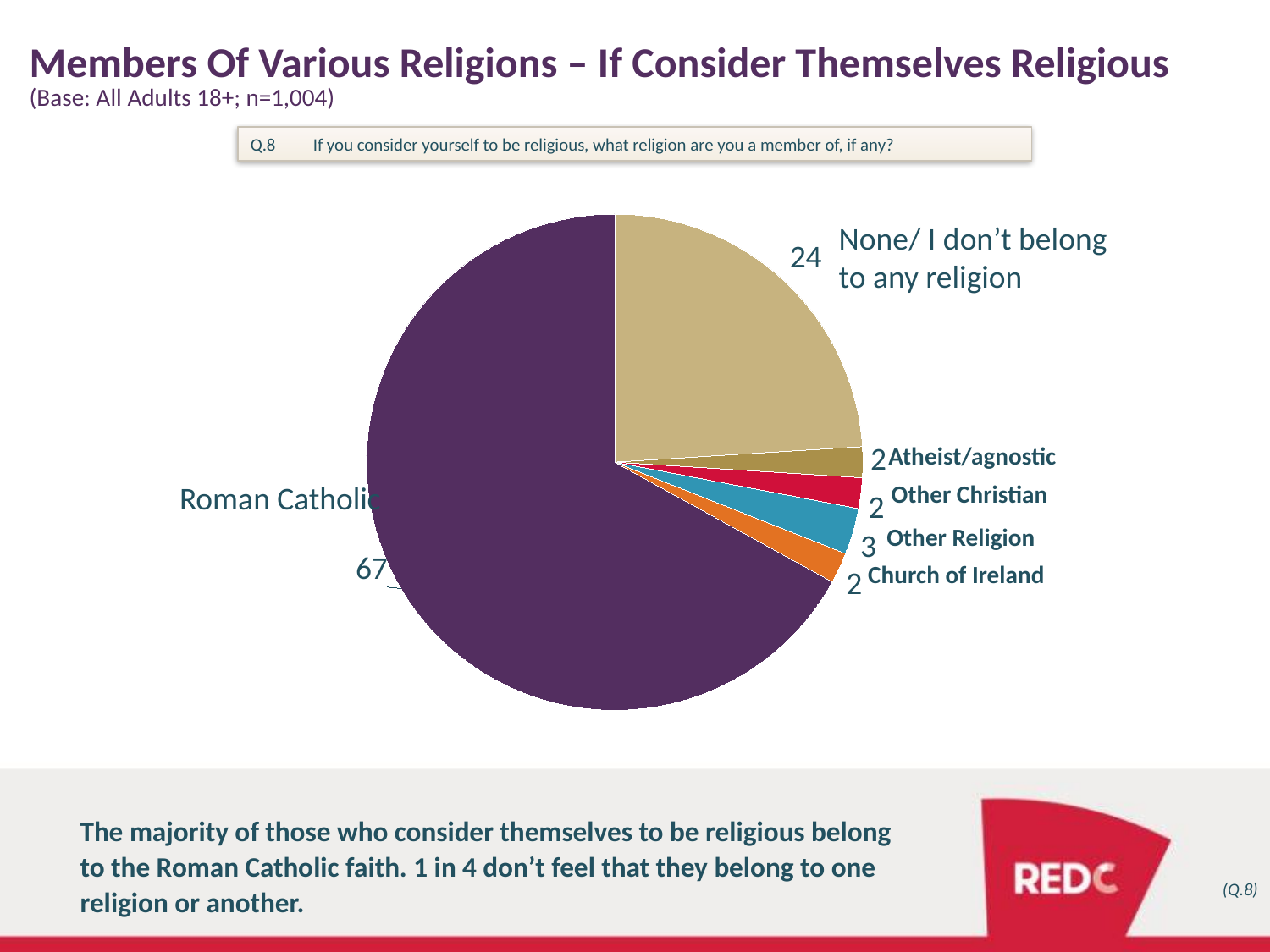
How many slices does the pie chart have? 6 Which is larger, the value for Other Religion or the value for Church of Ireland? Other Religion Which category has the largest slice of the pie? Roman Catholic What value is shown for Atheist/agnostic? 2 What value is shown for Other Religion? 3 What value is shown for Roman Catholic? 67 What value is shown for Church of Ireland? 2 What colour is the Roman Catholic slice? Purple What value is shown for None/ I don't belong to any religion? 24 What kind of chart is shown on the slide? Pie chart What is the difference between the values for Roman Catholic and None/ I don't belong to any religion? 43 What is the title of the slide's chart? Members Of Various Religions – If Consider Themselves Religious